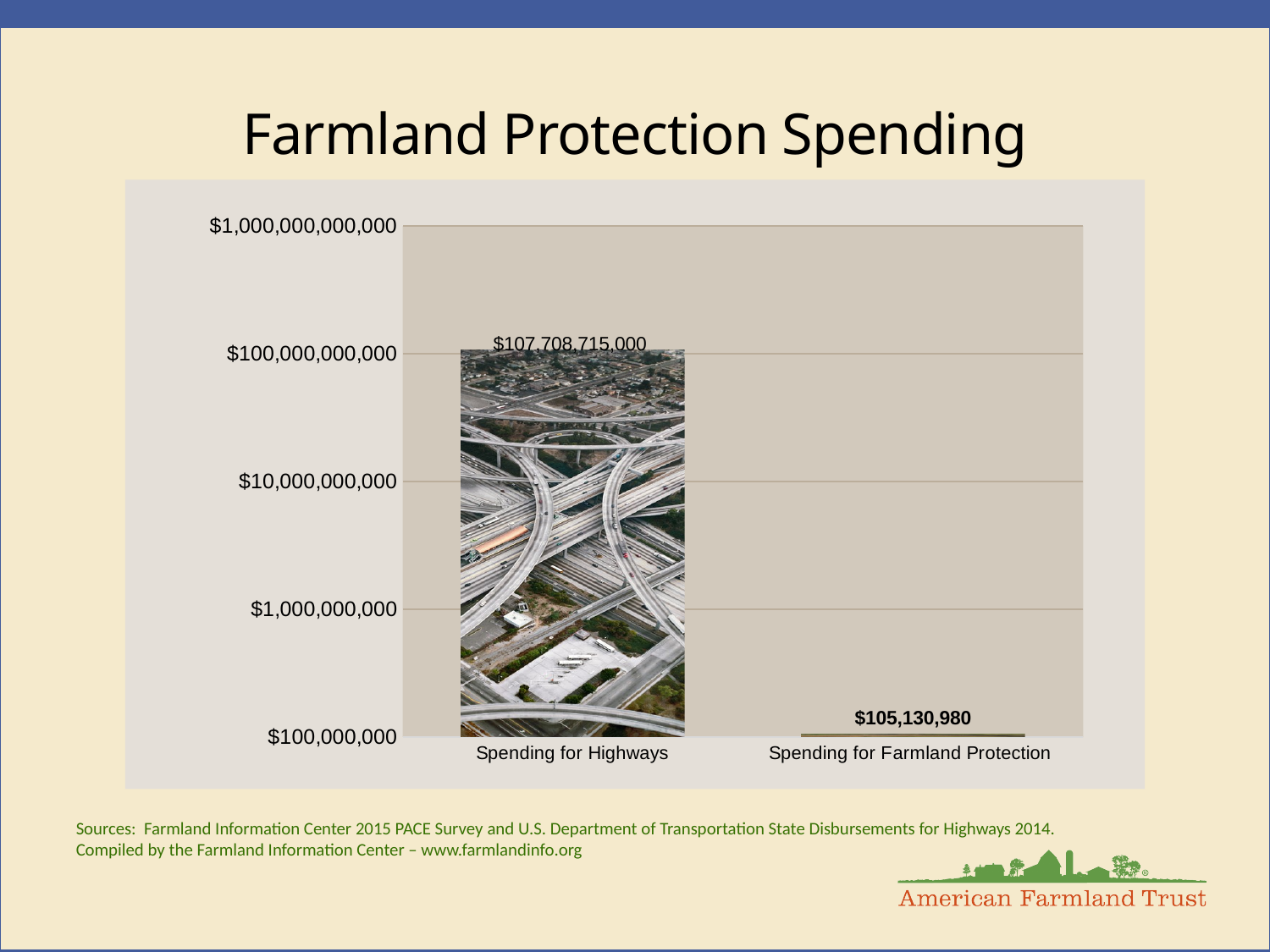
What kind of chart is shown on the slide? Bar chart Which is larger, Spending for Highways or Spending for Farmland Protection? Spending for Highways Is the value for Spending for Farmland Protection greater or less than $1,000,000,000? less What is the highest value labelled on the y axis? $1,000,000,000,000 What is the title of the slide? Farmland Protection Spending What is the difference between Spending for Highways and Spending for Farmland Protection? $107,603,584,020 What is the value for Spending for Highways? $107,708,715,000 How many categories are shown on the chart? 2 Which category has the lowest value? Spending for Farmland Protection Is the value for Spending for Highways greater or less than $100,000,000,000? greater Which category has the highest value? Spending for Highways What is the value for Spending for Farmland Protection? $105,130,980